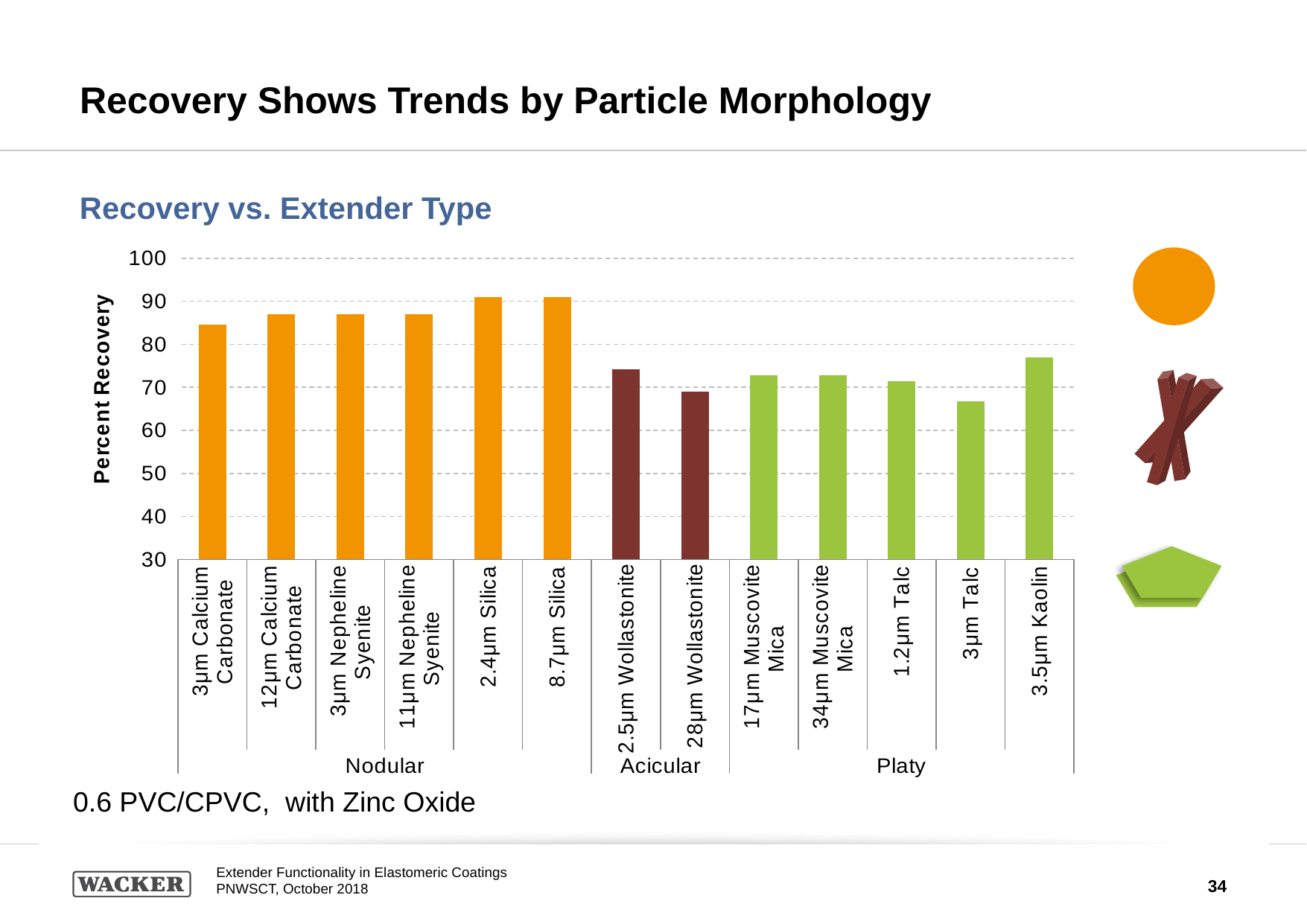
Which has a higher percent recovery, 2.4µm Silica or 2.5µm Wollastonite? 2.4µm Silica How many morphology groups are labelled along the x axis of the chart? 3 Is the value for 3µm Calcium Carbonate greater or less than 80? greater Is the value for 3.5µm Kaolin greater or less than 70? greater How many bars are in the Nodular group? 6 What is the label on the y axis of the chart? Percent Recovery Is the value for 3µm Talc greater or less than 70? less What is the title of the chart? Recovery vs. Extender Type What kind of chart is shown on the slide? Bar chart How many extender types (bars) are plotted in the chart? 13 Which has a higher percent recovery, 3.5µm Kaolin or 3µm Talc? 3.5µm Kaolin